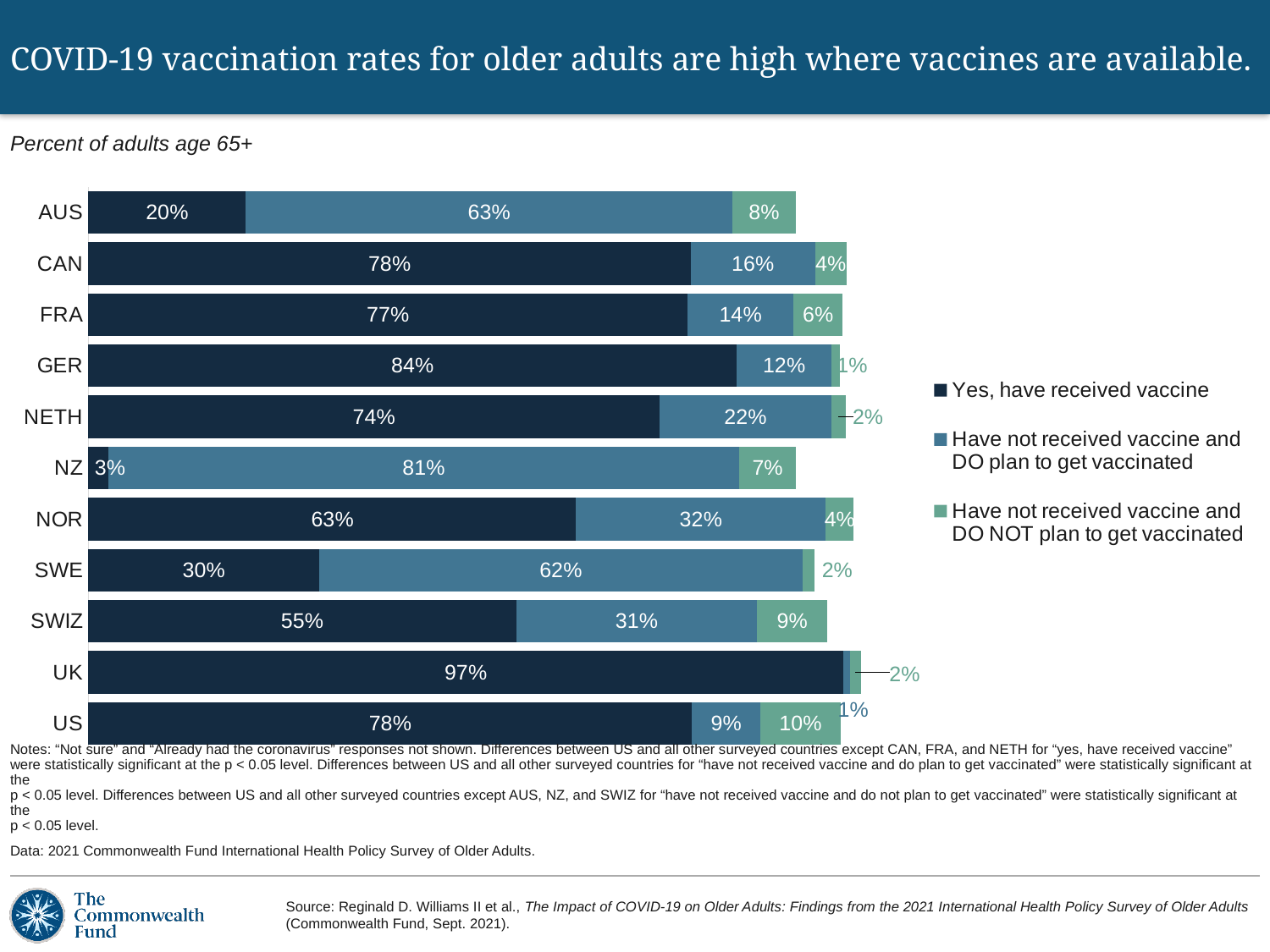
What percentage of adults age 65+ in NZ have not received the vaccine and DO plan to get vaccinated? 81% How many countries are shown in the chart? 11 How many series does the legend list? 3 What is the subtitle shown above the chart? Percent of adults age 65+ What kind of chart is shown on the slide? Stacked bar chart What percentage of adults age 65+ in the UK have received the vaccine? 97% What percentage of adults age 65+ in the US have not received the vaccine and DO NOT plan to get vaccinated? 10% What is the total of the three labeled segments for CAN? 98% What is the difference in percentage points between GER and NETH for 'Yes, have received vaccine'? 10 percentage points Which country has the lowest share of adults age 65+ who have received the vaccine? NZ Which country has the highest share of adults age 65+ who have received the vaccine? UK Which has a higher share of adults who have received the vaccine, AUS or SWE? SWE